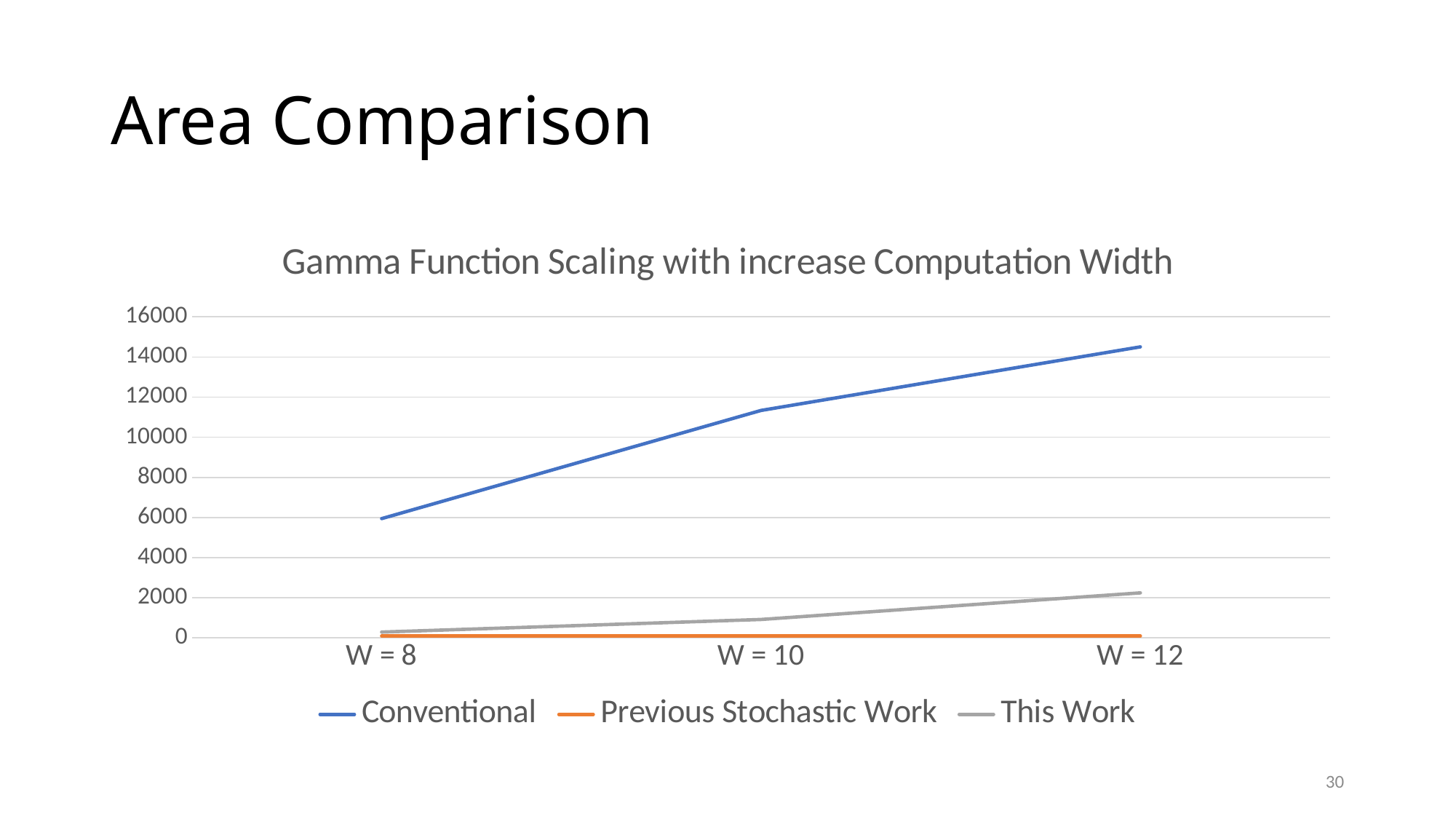
Does the Conventional series rise or fall as W increases from 8 to 12? rise Is the value for Conventional at W = 8 greater or less than 8000? less Which colour is used for the This Work series? gray Which is larger at W = 10: the value for Conventional or the value for This Work? Conventional Which series has the highest value at W = 12? Conventional How many series does the legend list? 3 Is the value for Conventional at W = 12 greater or less than 14000? greater What kind of chart is shown on the slide? line chart Which series has the lowest value at W = 8? Previous Stochastic Work Is the value for This Work at W = 12 greater or less than 4000? less What is the title of the chart? Gamma Function Scaling with increase Computation Width How many points are plotted along the x axis for each series? 3